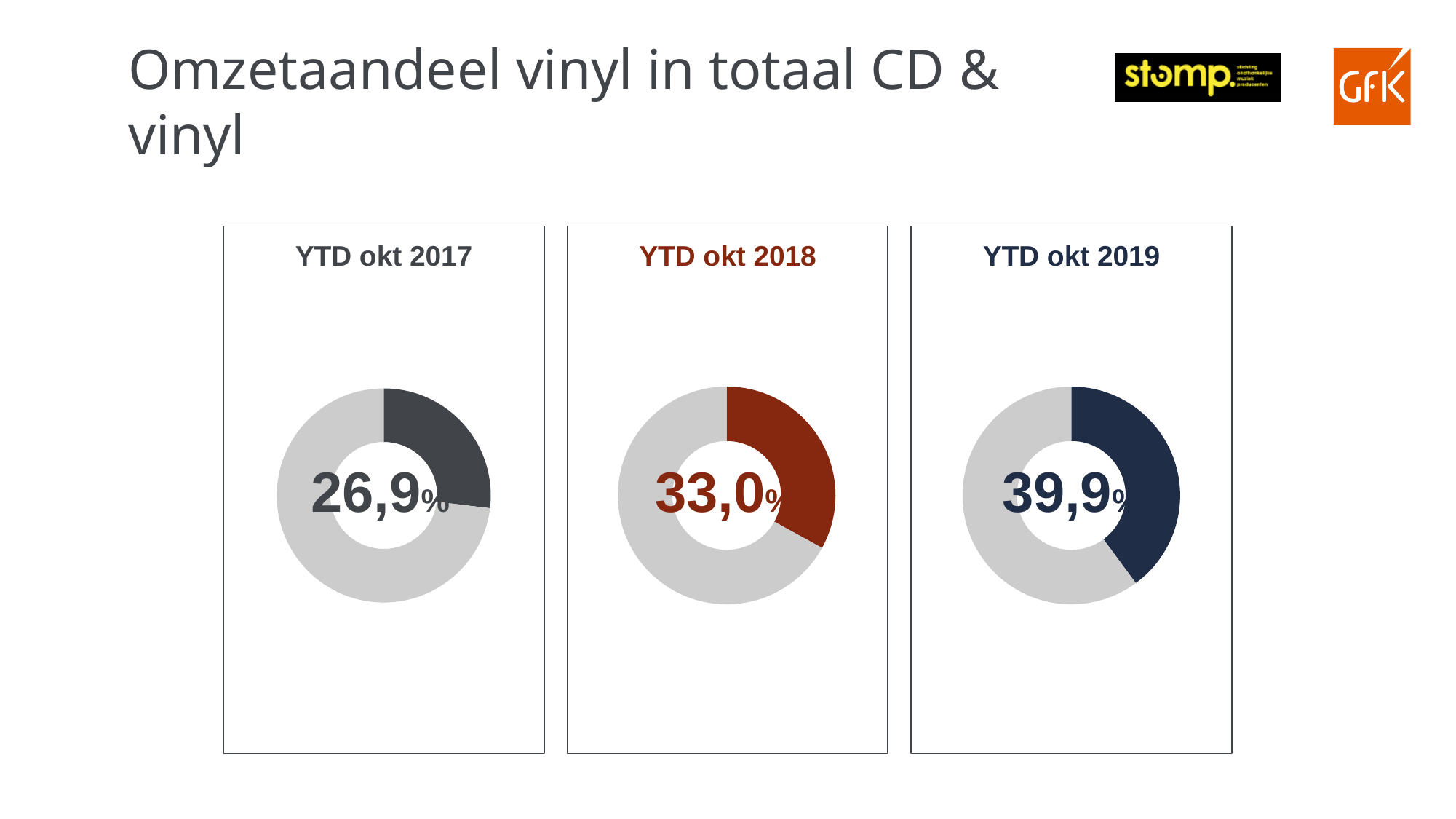
In the YTD okt 2018 chart, what is the vinyl share shown in the centre? 33,0% Which is larger, the vinyl share in YTD okt 2018 or in YTD okt 2019? YTD okt 2019 By how many percentage points did the vinyl share rise from YTD okt 2018 to YTD okt 2019? 6,9 How many donut charts are shown on the slide? 3 Which of the three charts shows the lowest vinyl share? YTD okt 2017 What kind of chart is used to show the vinyl share for each period? donut (pie) chart Which of the three charts shows the highest vinyl share? YTD okt 2019 By how many percentage points is the YTD okt 2019 vinyl share higher than the YTD okt 2017 share? 13,0 By how many percentage points did the vinyl share rise from YTD okt 2017 to YTD okt 2018? 6,1 In the YTD okt 2017 chart, what share of revenue does vinyl have? 26,9% In the YTD okt 2019 chart, what is the vinyl share shown? 39,9% Does the vinyl share rise or fall from YTD okt 2017 to YTD okt 2019? rise